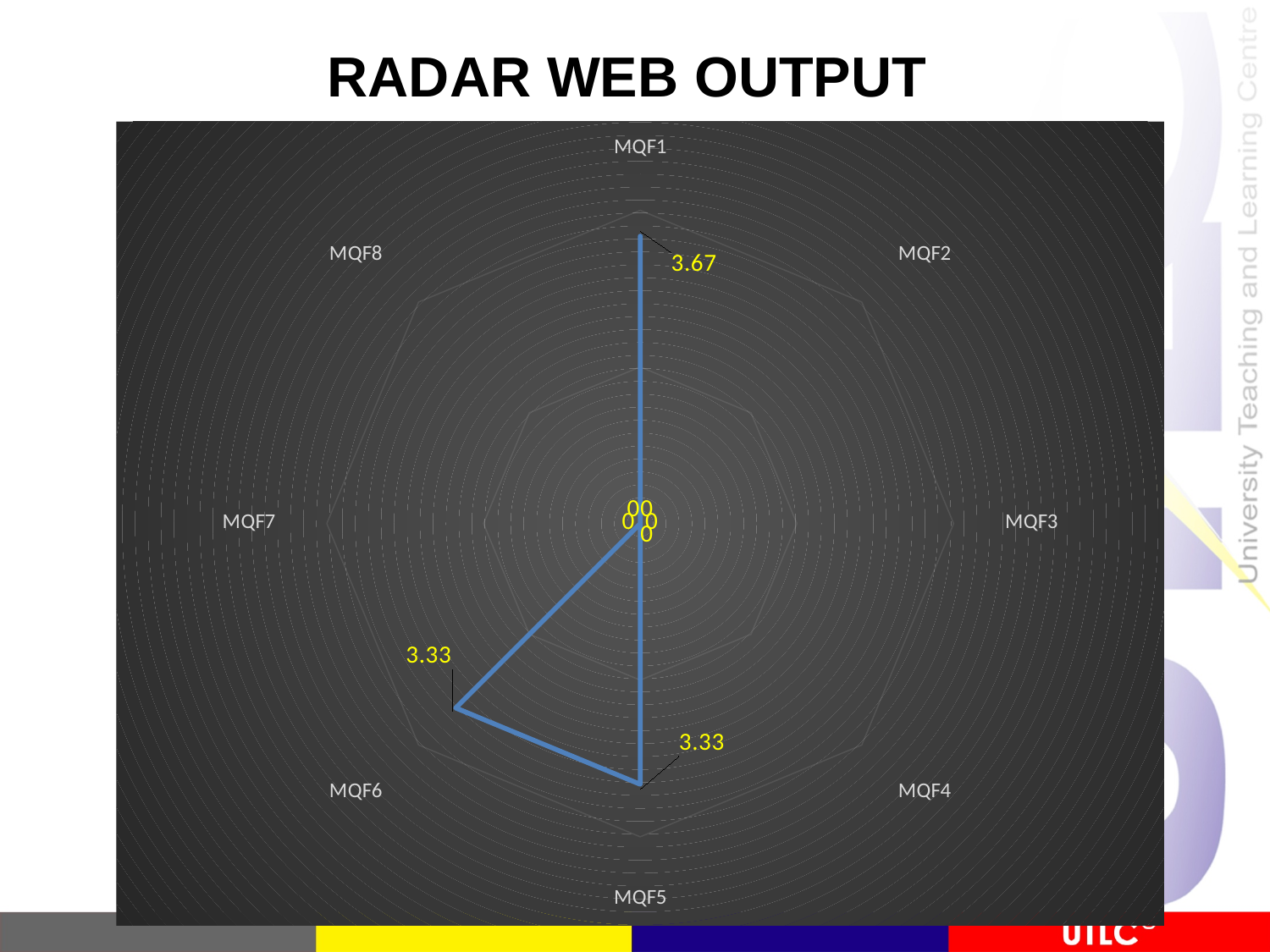
Which is larger, the value for MQF1 or the value for MQF6? MQF1 What is the value for MQF3? 0 What is the value for MQF5? 3.33 What is the title of the slide? RADAR WEB OUTPUT What is the value for MQF6? 3.33 How many categories have a non-zero value? 3 What is the difference between the values for MQF1 and MQF5? 0.34 How many categories are plotted on the chart? 8 Which category has the highest value? MQF1 Which category is labelled at the top of the radar chart? MQF1 What is the value for MQF1? 3.67 What kind of chart is shown on the slide? Radar chart